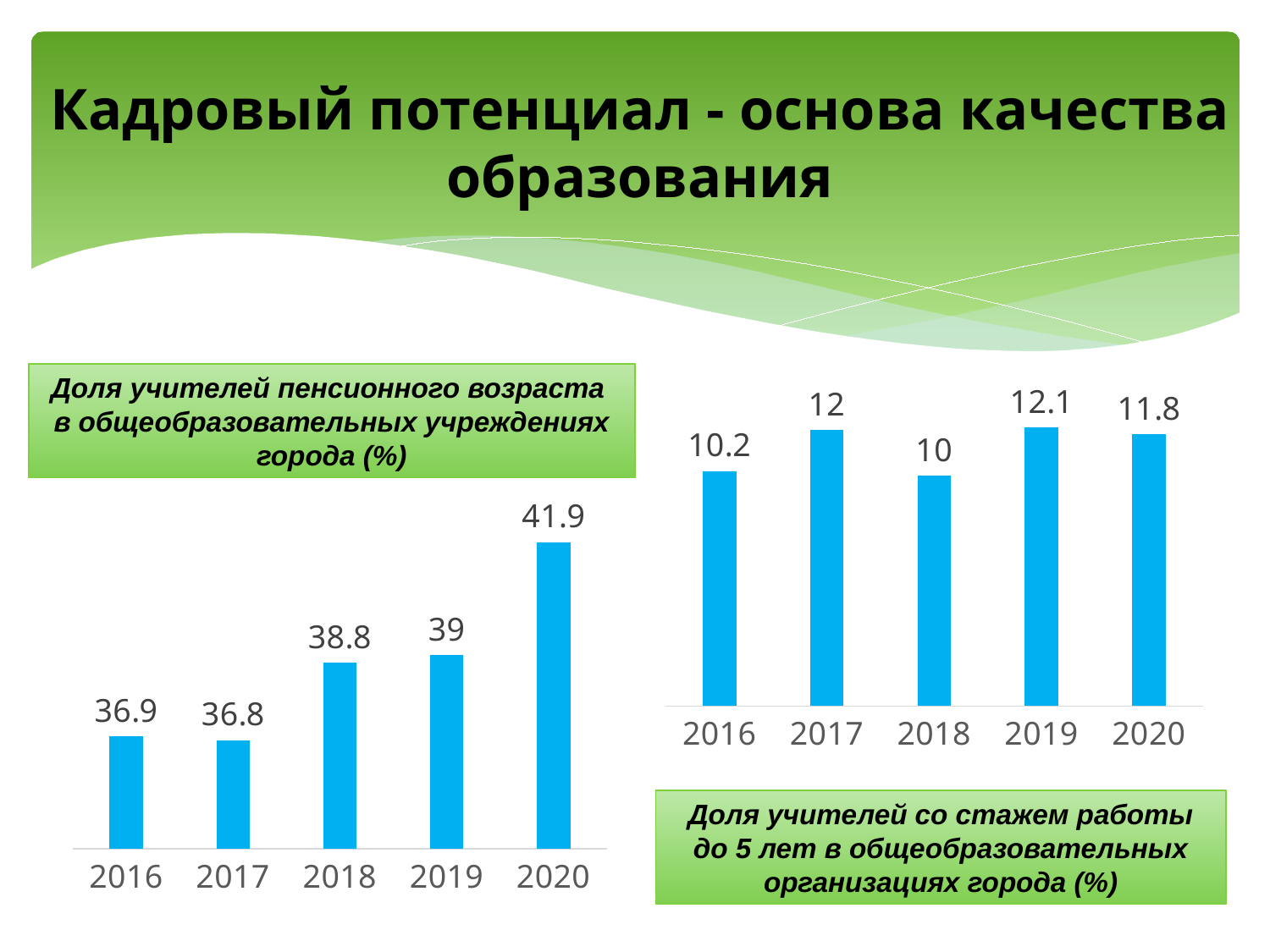
In the right chart (share of teachers with up to 5 years of experience), what is the value for 2019? 12.1 In the right chart (share of teachers with up to 5 years of experience), what is the value for 2018? 10 In the left chart (share of teachers of retirement age), how many years are shown on the x axis? 5 In the right chart (share of teachers with up to 5 years of experience), what is the difference between the 2017 and 2016 values? 1.8 What kind of chart is the left chart (share of teachers of retirement age)? Bar chart In the right chart (share of teachers with up to 5 years of experience), which year has the lowest value? 2018 In the left chart (share of teachers of retirement age), which year has the highest value? 2020 In the left chart (share of teachers of retirement age), what is the difference between the 2020 and 2016 values? 5 In the right chart (share of teachers with up to 5 years of experience), which is larger, the value for 2017 or the value for 2020? 2017 In the left chart (share of teachers of retirement age), what is the value for 2020? 41.9 In the left chart (share of teachers of retirement age), which year has the lowest value? 2017 In the left chart (share of teachers of retirement age), what is the value for 2017? 36.8